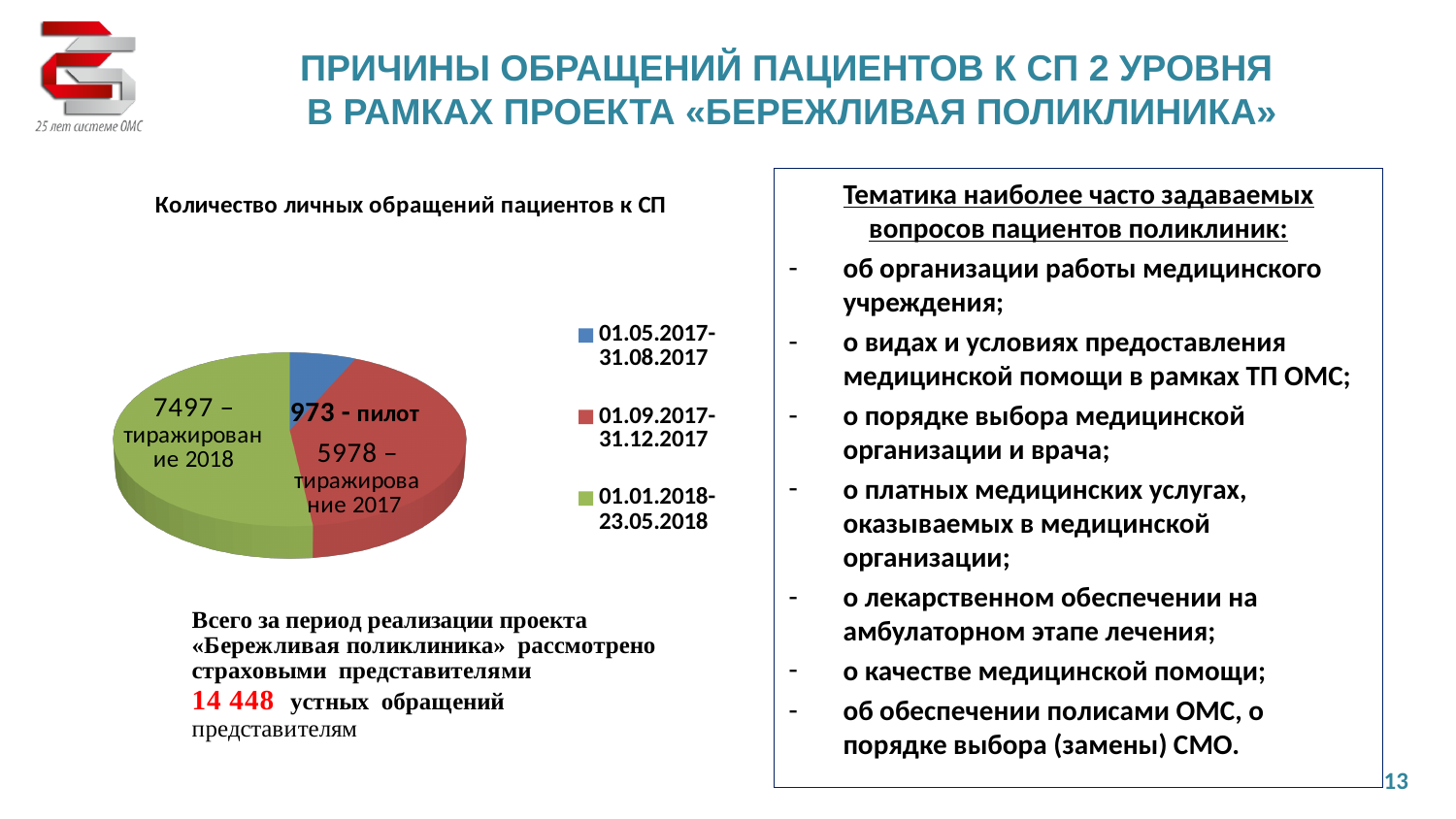
How many entries does the legend of the pie chart list? 3 What colour is the slice for the period 01.05.2017-31.08.2017 (пилот) in the pie chart? blue In the pie chart, which is larger: the value for тиражирование 2017 or the value for пилот? тиражирование 2017 Which period has the largest slice in the pie chart? 01.01.2018-23.05.2018 (тиражирование 2018) In the pie chart, what is the number of personal patient requests for the period 01.01.2018-23.05.2018 (тиражирование 2018)? 7497 What kind of chart is shown under the title «Количество личных обращений пациентов к СП»? pie chart What is the total number of oral requests across all three periods shown in the pie chart? 14 448 Which period has the smallest slice in the pie chart? 01.05.2017-31.08.2017 (пилот) How many slices does the pie chart «Количество личных обращений пациентов к СП» have? 3 In the pie chart, what is the number of personal patient requests for the period 01.05.2017-31.08.2017 (пилот)? 973 In the pie chart, what is the number of personal patient requests for the period 01.09.2017-31.12.2017 (тиражирование 2017)? 5978 In the pie chart, what is the difference between the value for тиражирование 2018 and the value for тиражирование 2017? 1519